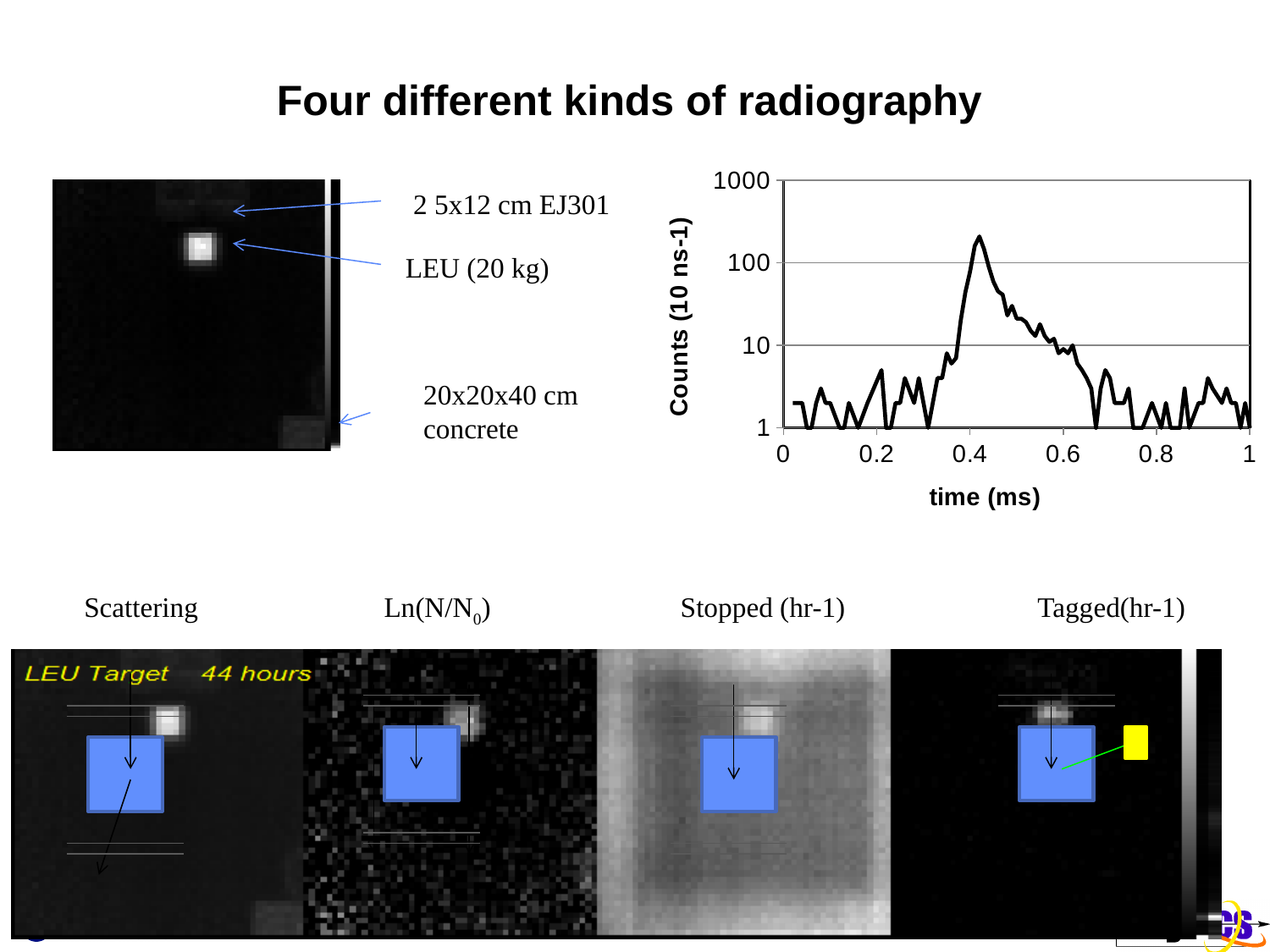
Which is larger on the line chart, the value at 0.4 ms or the value at 0.8 ms? 0.4 ms What is the label of the y axis of the line chart? Counts (10 ns-1) Is the peak value of the line chart greater or less than 1000? less Does the line chart rise or fall between 0.4 ms and 0.6 ms after the peak? fall What is the label of the x axis of the line chart? time (ms) Is the value on the line chart at time 0.4 ms greater or less than 10? greater How many lines are plotted on the line chart? 1 Is the value on the line chart at time 0.8 ms greater or less than 10? less What kind of chart is shown on the right of the slide? line chart Between which two x-axis ticks does the peak of the line chart occur? 0.4 and 0.6